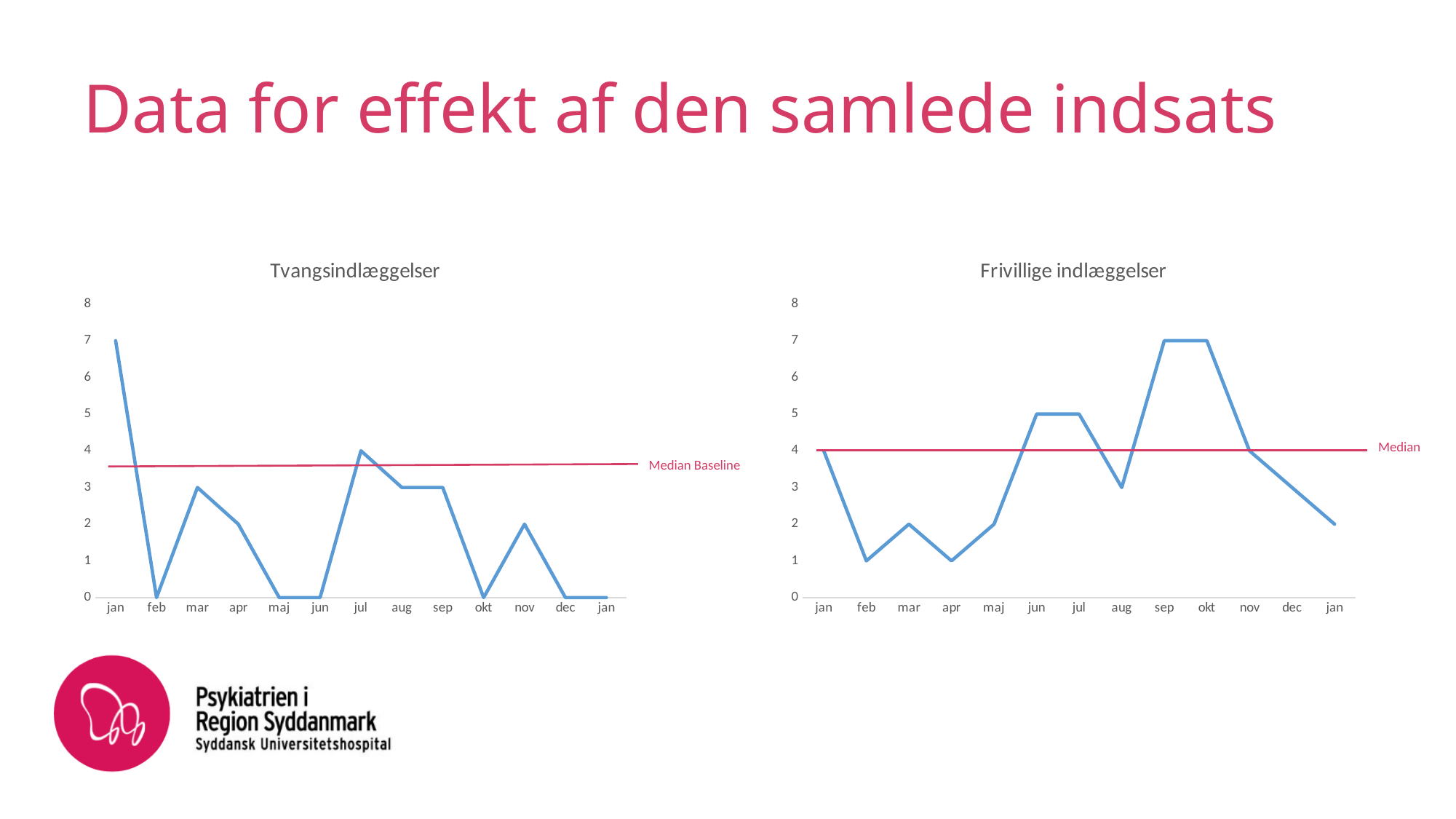
In the 'Tvangsindlæggelser' chart, what is the value for the first jan? 7 In the 'Frivillige indlæggelser' chart, what value does the Median line sit at? 4 What is the label of the red horizontal line in the 'Tvangsindlæggelser' chart? Median Baseline In the 'Frivillige indlæggelser' chart, what is the value for feb? 1 In the 'Tvangsindlæggelser' chart, what is the value for jul? 4 In the 'Frivillige indlæggelser' chart, which is larger, the value for jun or the value for aug? jun What kind of chart is the 'Tvangsindlæggelser' chart? line chart In the 'Tvangsindlæggelser' chart, how many months are plotted on the x axis? 13 In the 'Tvangsindlæggelser' chart, which month has the highest value? jan (the first) In the 'Frivillige indlæggelser' chart, what is the value for sep? 7 In the 'Tvangsindlæggelser' chart, what is the difference between the value for mar and the value for nov? 1 In the 'Frivillige indlæggelser' chart, what is the difference between the value for okt and the value for nov? 3